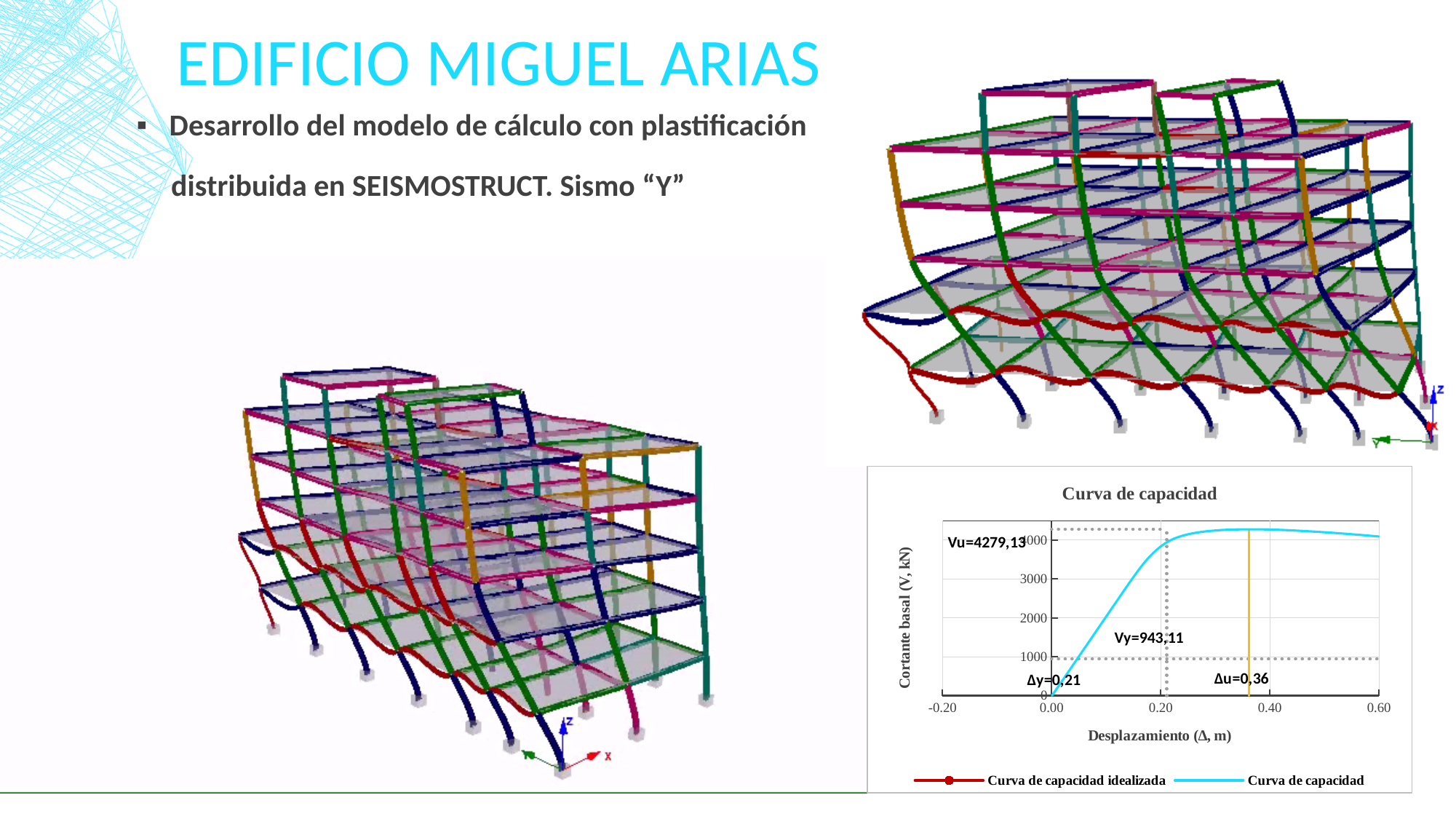
What are the two series named in the legend of the 'Curva de capacidad' chart? Curva de capacidad idealizada and Curva de capacidad What kind of chart is the 'Curva de capacidad' chart? line chart In the 'Curva de capacidad' chart, what value is given for Δy? 0,21 In the 'Curva de capacidad' chart, what value is given for Vy? 943,11 In the 'Curva de capacidad' chart, what is the difference between Δu and Δy? 0,15 In the 'Curva de capacidad' chart, what value is given for Δu? 0,36 In the 'Curva de capacidad' chart, what is the difference between Vu and Vy? 3336,02 How many series does the legend of the 'Curva de capacidad' chart list? 2 In the 'Curva de capacidad' chart, is the base shear at a displacement of 0.20 m greater or less than 3000? greater In the 'Curva de capacidad' chart, which is larger, Vu or Vy? Vu In the 'Curva de capacidad' chart, what value is given for Vu? 4279,13 What is the title of the chart on the slide? Curva de capacidad